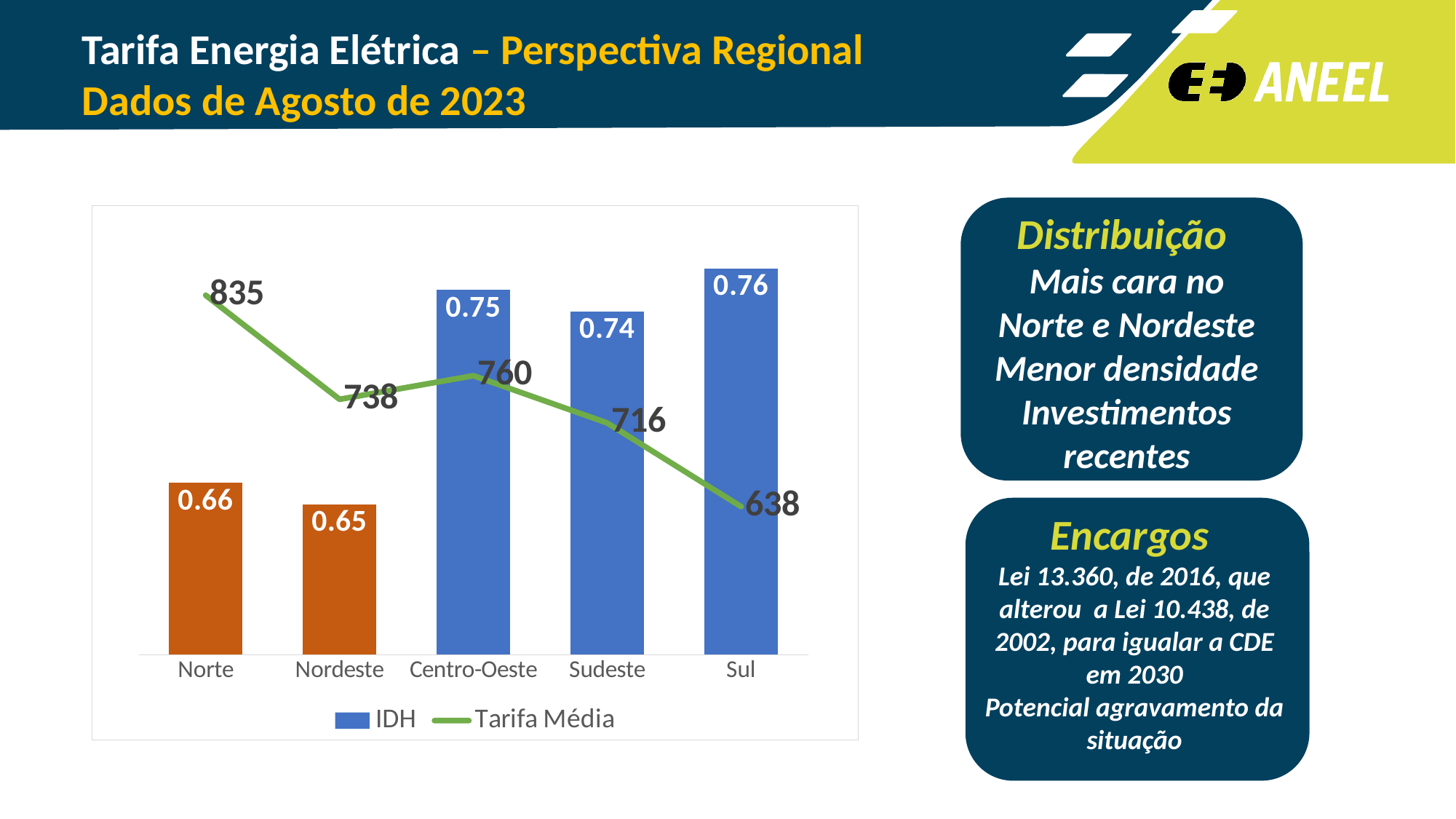
How many series does the legend list? 2 Which region has the lowest IDH? Nordeste What is the IDH value for Sul? 0.76 What is the Tarifa Média value for Sudeste? 716 What is the IDH value for Norte? 0.66 What is the Tarifa Média value for Nordeste? 738 Which region has the highest Tarifa Média? Norte Which series is drawn as a green line? Tarifa Média What is the difference between the Tarifa Média for Norte and for Sul? 197 Does the Tarifa Média line generally rise or fall from Norte to Sul? fall How many regions are shown on the x axis? 5 Which region has a higher IDH, Centro-Oeste or Sudeste? Centro-Oeste